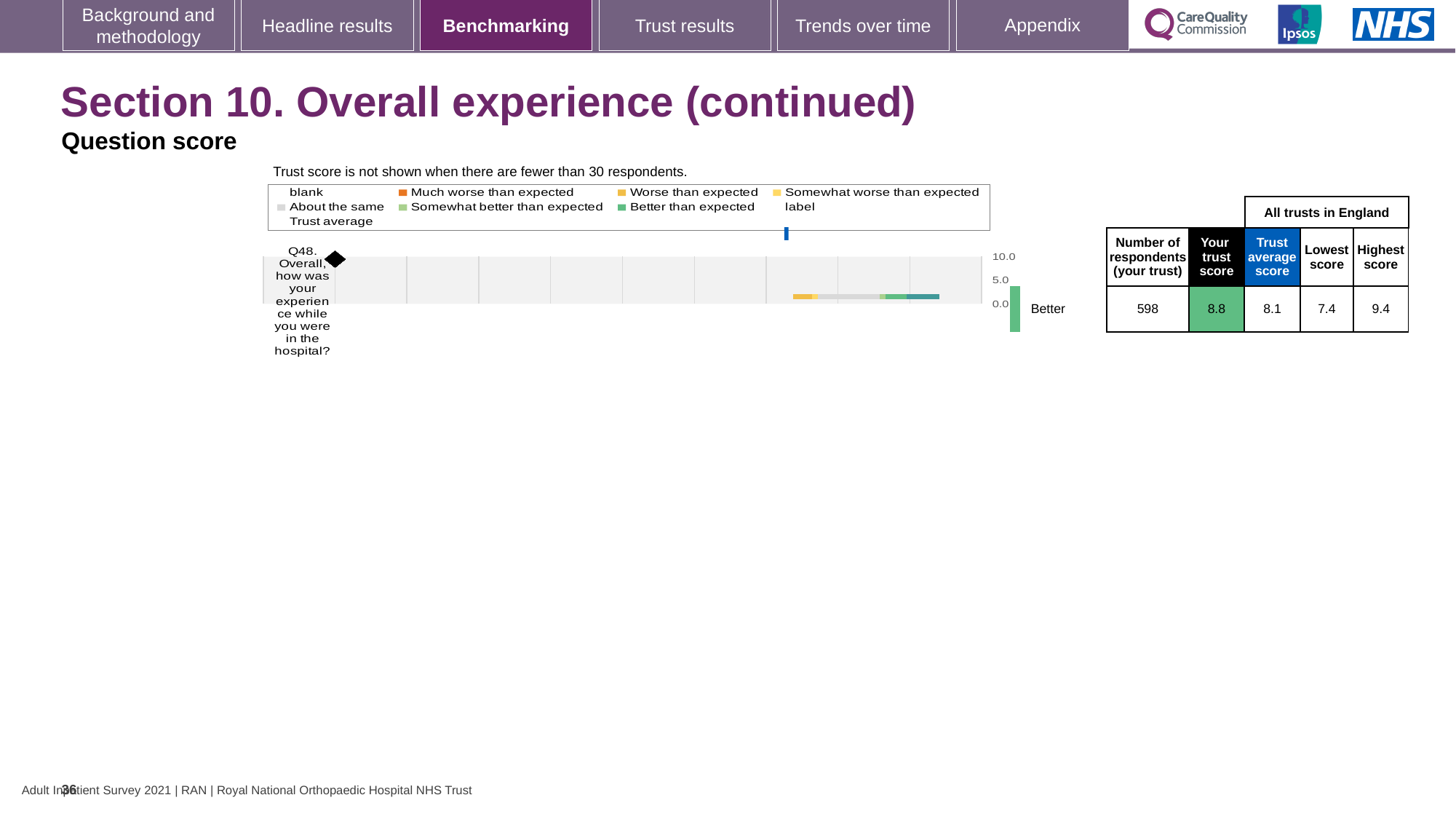
What kind of chart is used to show the Q48 benchmarking result? Bar chart How many survey questions are plotted on the benchmarking chart? 1 What is the 'Lowest score' among all trusts in England for Q48? 7.4 What is the difference between your trust score and the trust average score for Q48? 0.7 Which is larger for Q48: your trust score or the trust average score? Your trust score How many respondents from your trust answered Q48? 598 What is the 'Your trust score' value for Q48? 8.8 What colour does the legend use for 'Much worse than expected'? Orange Which question is plotted on the benchmarking chart? Q48. Overall, how was your experience while you were in the hospital? What is the 'Trust average score' for Q48? 8.1 What is the 'Highest score' among all trusts in England for Q48? 9.4 What is the difference between the highest score and the lowest score for Q48? 2.0